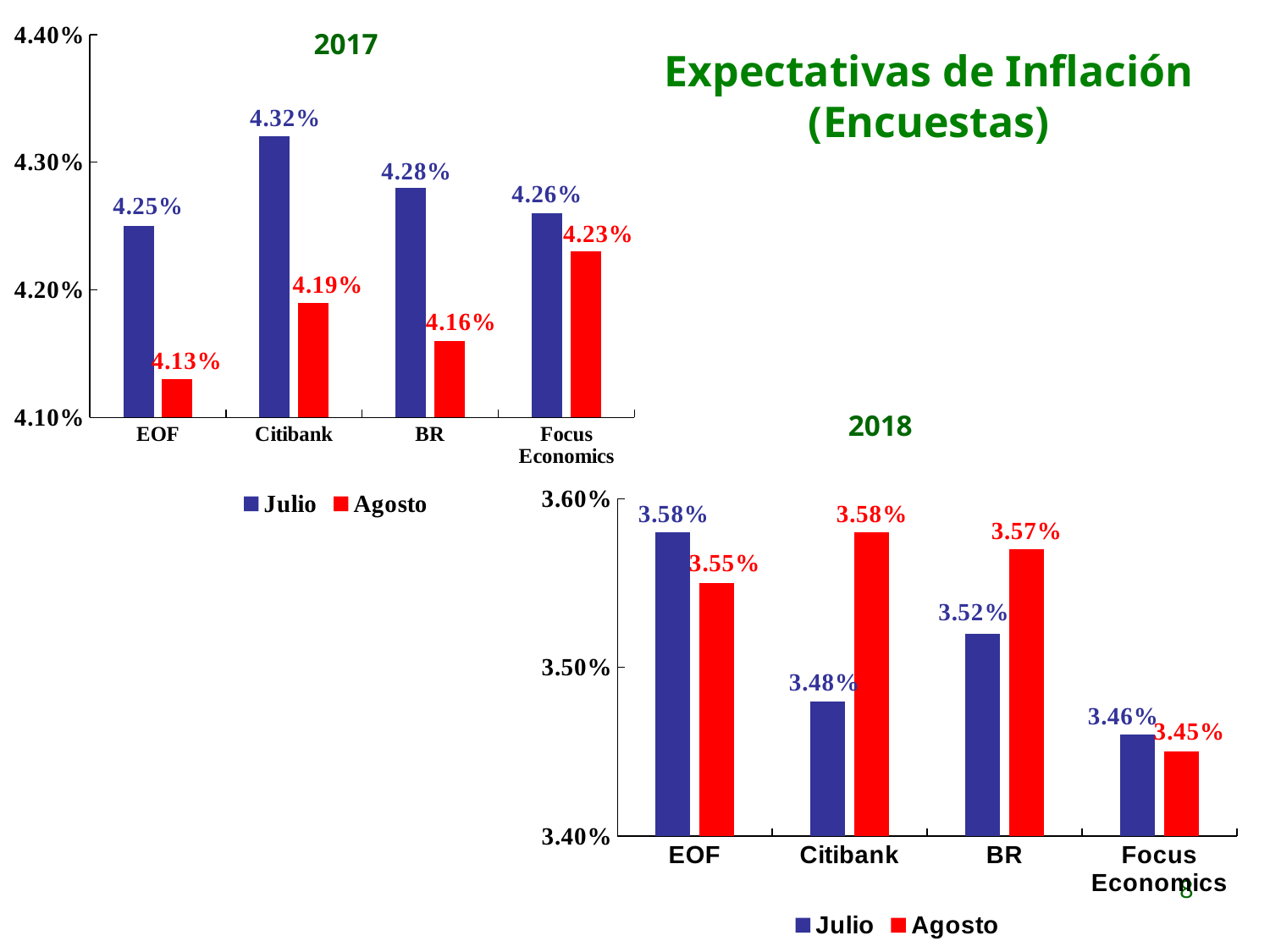
How many categories are shown on the x axis of the 2018 chart? 4 How many series does the legend of the 2017 chart list? 2 In the 2017 chart, what is the Julio value for Citibank? 4.32% In the 2018 chart, what is the Agosto value for BR? 3.57% What type of chart is the 2018 chart? Bar chart In the 2017 chart, which category has the highest Julio value? Citibank In the 2017 chart, what is the Agosto value for EOF? 4.13% In the 2018 chart, what is the Julio value for Focus Economics? 3.46% In the 2017 chart, what is the difference between the Julio and Agosto values for EOF? 0.12% In the 2017 chart, which is larger for BR: the Julio value or the Agosto value? Julio In the 2018 chart, which category has the lowest Agosto value? Focus Economics In the 2018 chart, what is the difference between the Agosto and Julio values for Citibank? 0.10%